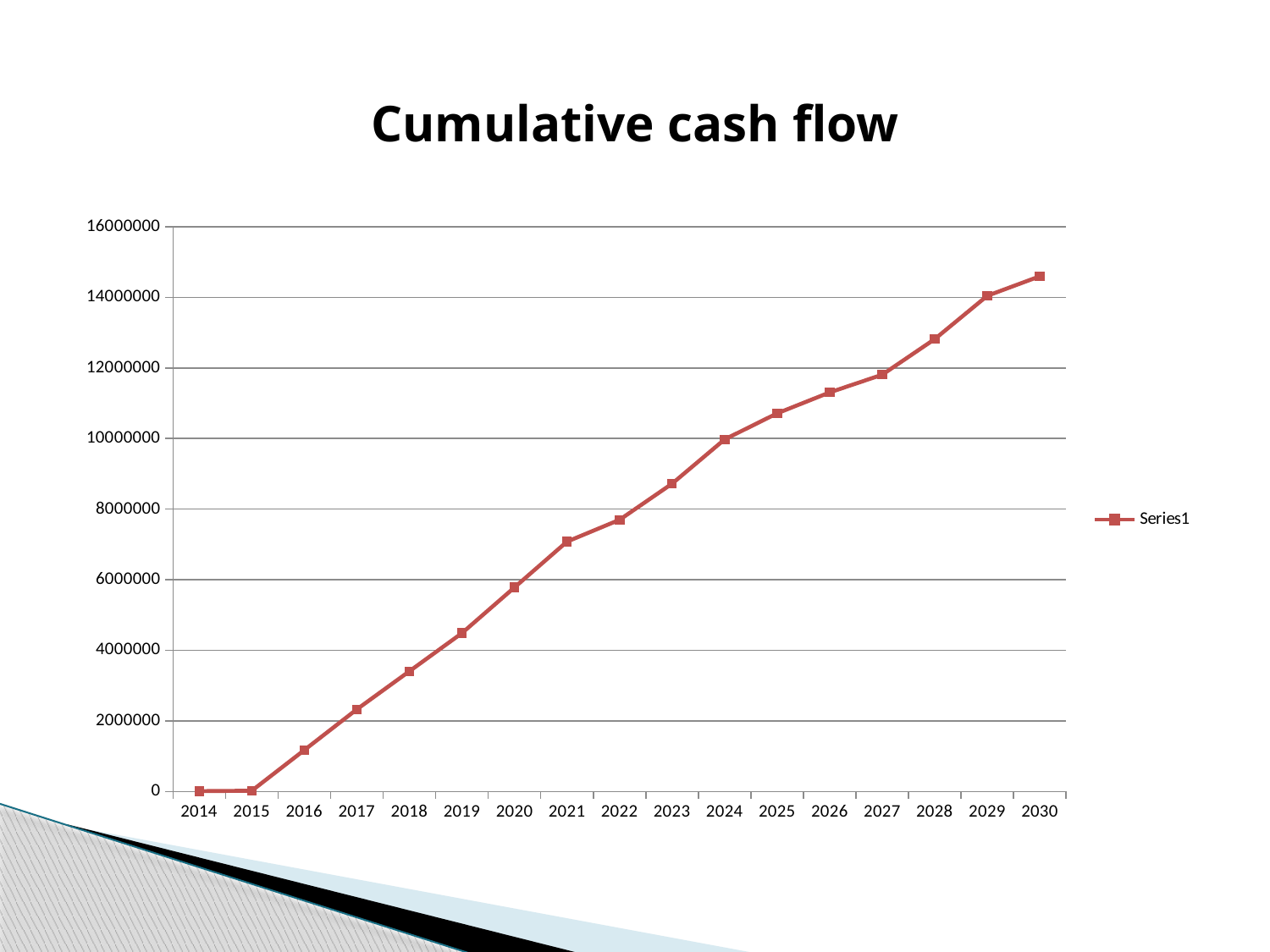
What is the title of the chart? Cumulative cash flow Which is larger, the value for 2025 or the value for 2020? 2025 How many series does the legend list? 1 Is the value for 2017 greater or less than 2000000? greater Is the value for 2030 greater or less than 14000000? greater Is the value for 2020 greater or less than 6000000? less Which year has the highest cumulative cash flow? 2030 What kind of chart is shown on the slide? line chart Do the values rise or fall from 2014 to 2030? rise How many years are plotted on the x axis? 17